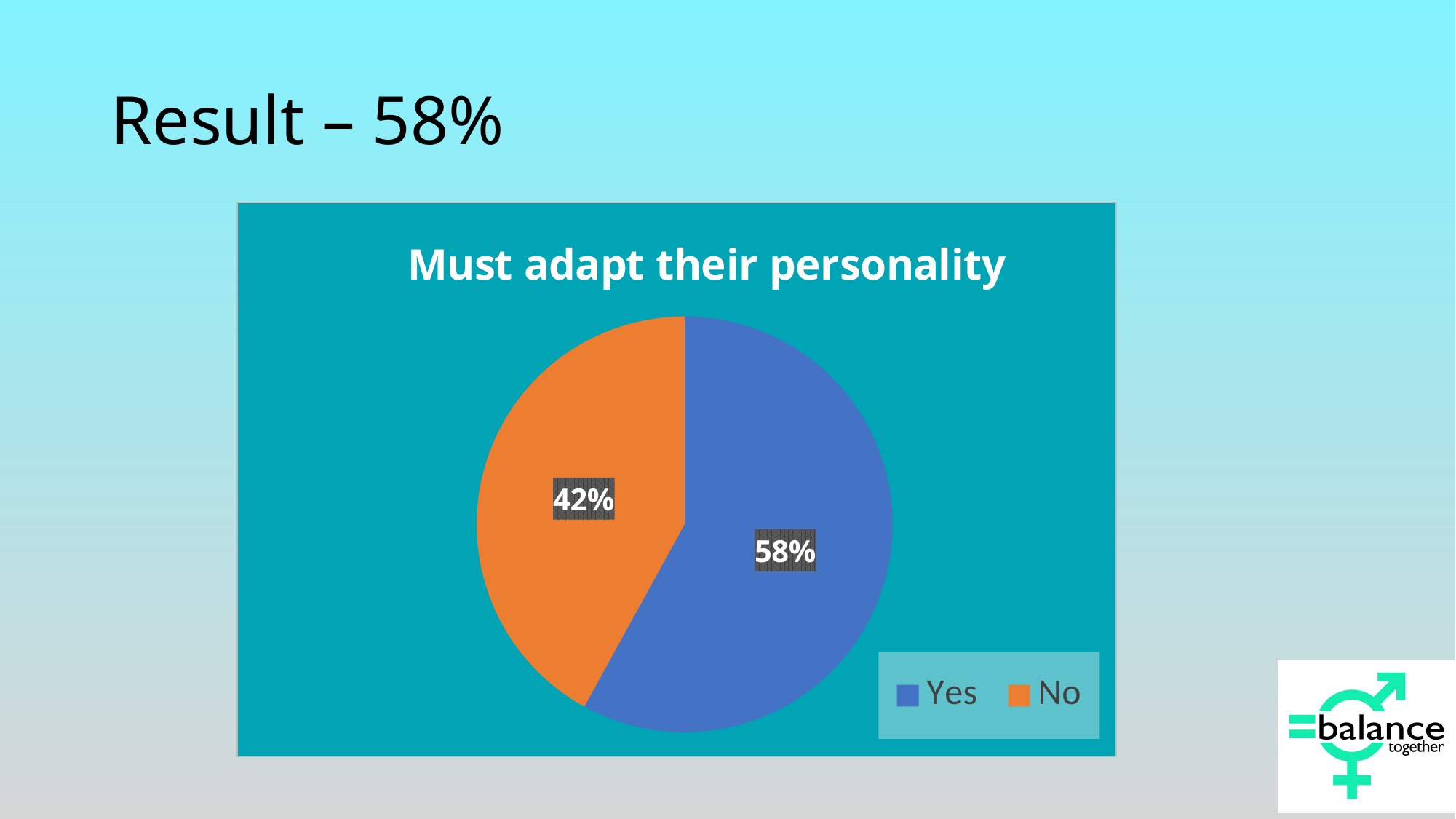
What kind of chart is shown on the slide? pie chart What is the difference in percentage points between the "Yes" and "No" slices? 16 What percentage of the pie is labelled "Yes"? 58% What share of the pie does the "Yes" slice represent? 58% What percentage of the pie is labelled "No"? 42% Which slice of the pie is the largest? Yes Which is larger, the "Yes" slice or the "No" slice? Yes Which slice of the pie is the smallest? No What is the title of the chart? Must adapt their personality How many entries does the legend list? 2 How many slices does the pie chart have? 2 What colour is the "No" slice in the pie chart? orange